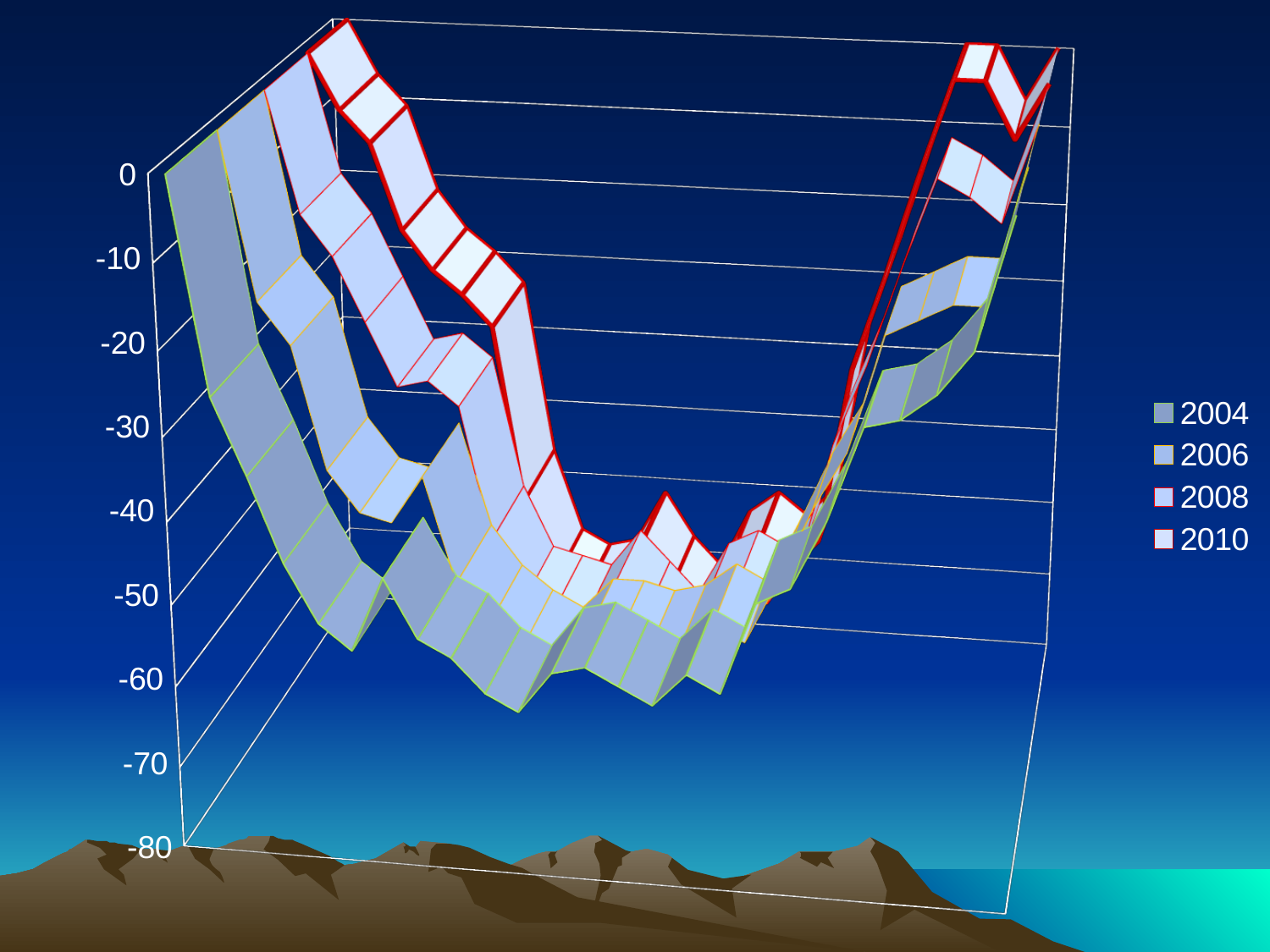
What is the highest value shown on the vertical axis? 0 Do the values along the x axis first fall and then rise, or first rise and then fall? first fall and then rise Which series is listed last in the legend? 2010 What is the lowest value shown on the vertical axis? -80 Which series is listed first in the legend? 2004 How many series does the legend list? 4 What kind of chart is shown on the slide? line chart